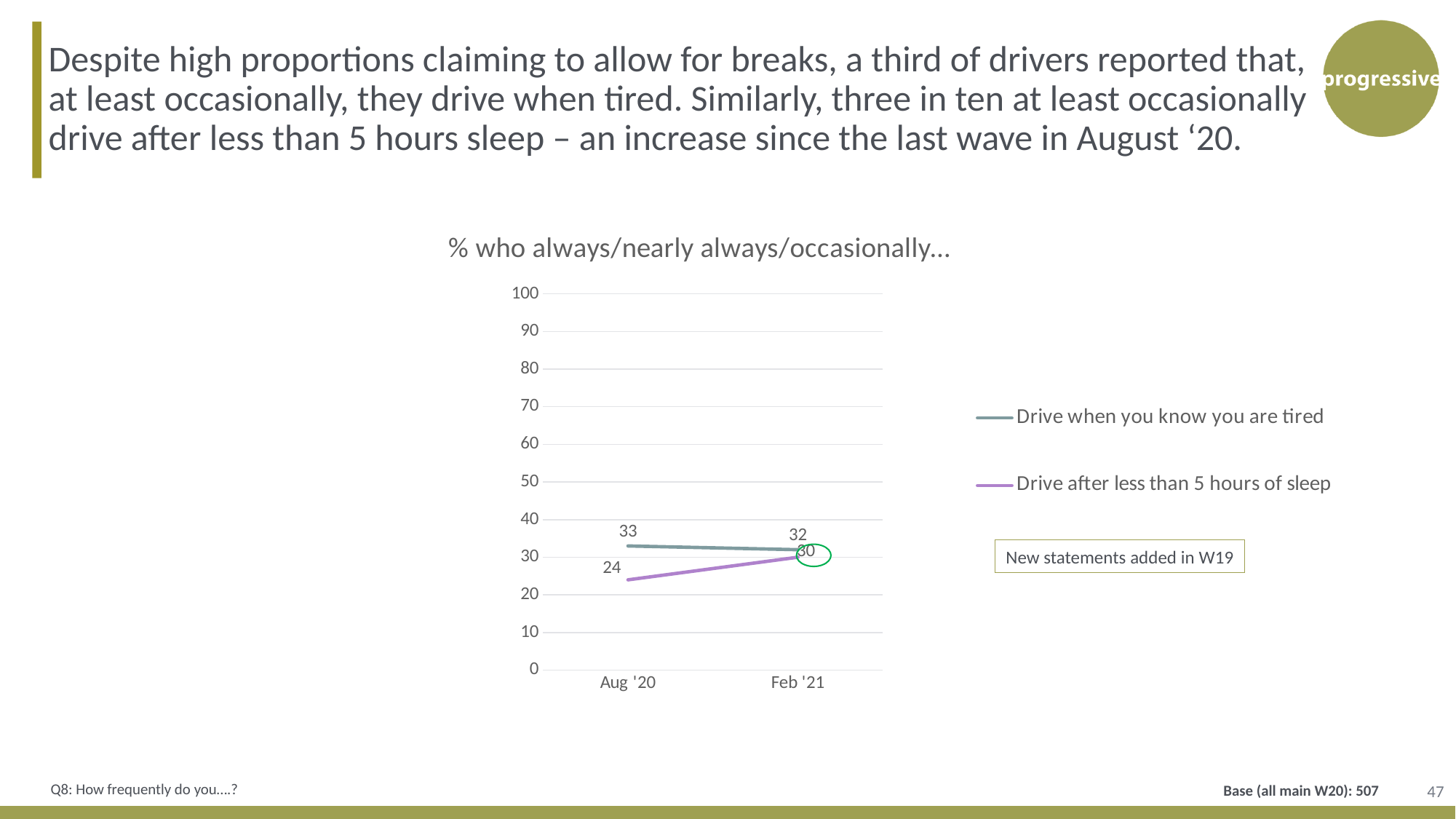
What kind of chart is shown on the slide? line chart What is the value for 'Drive after less than 5 hours of sleep' in Feb '21? 30 What is the value for 'Drive when you know you are tired' in Aug '20? 33 Does the 'Drive after less than 5 hours of sleep' series rise or fall from Aug '20 to Feb '21? rise What is the value for 'Drive when you know you are tired' in Feb '21? 32 Which series has the higher value in Aug '20? Drive when you know you are tired What is the difference between the two series in Aug '20? 9 How many time points are shown on the x axis? 2 What is the value for 'Drive after less than 5 hours of sleep' in Aug '20? 24 Does the 'Drive when you know you are tired' series rise or fall from Aug '20 to Feb '21? fall How many series does the legend list? 2 By how much did 'Drive after less than 5 hours of sleep' change between Aug '20 and Feb '21? 6